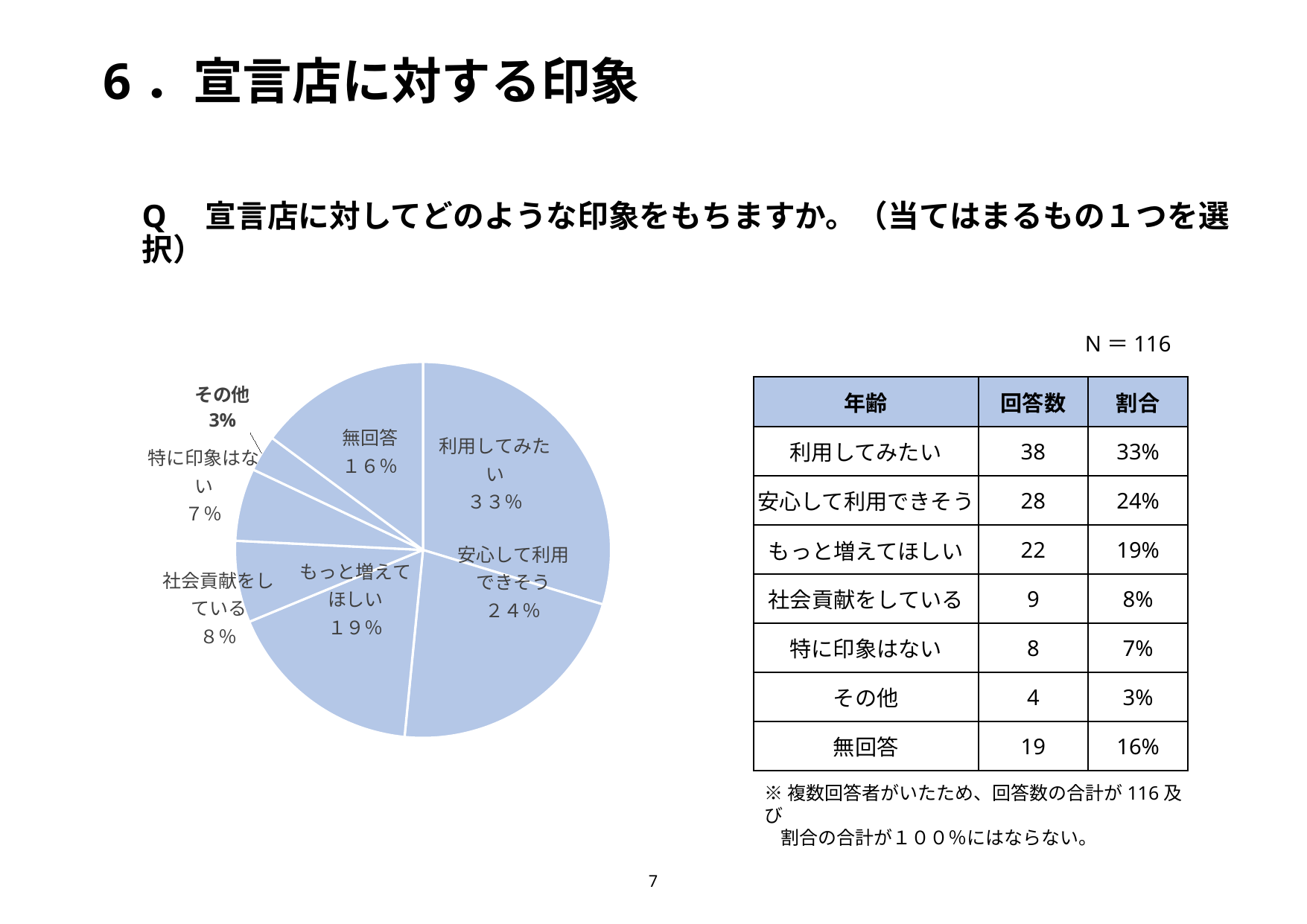
What share of the pie does 特に印象はない represent? ７％ What percentage is shown for 安心して利用できそう in the pie chart? ２４％ Which category has the smallest slice in the pie chart? その他 Are the slices of the pie chart shown in different colours or all in the same colour? all in the same colour What percentage is shown for 利用してみたい in the pie chart? ３３％ What type of chart is shown on the slide? pie chart What is the difference in percentage points between 利用してみたい and 安心して利用できそう in the pie chart? 9 Which slice is larger in the pie chart, もっと増えてほしい or 無回答? もっと増えてほしい What percentage is shown for 無回答 in the pie chart? １６％ Which category has the largest slice in the pie chart? 利用してみたい What percentage is shown for 社会貢献をしている in the pie chart? ８％ How many slices does the pie chart have? 7